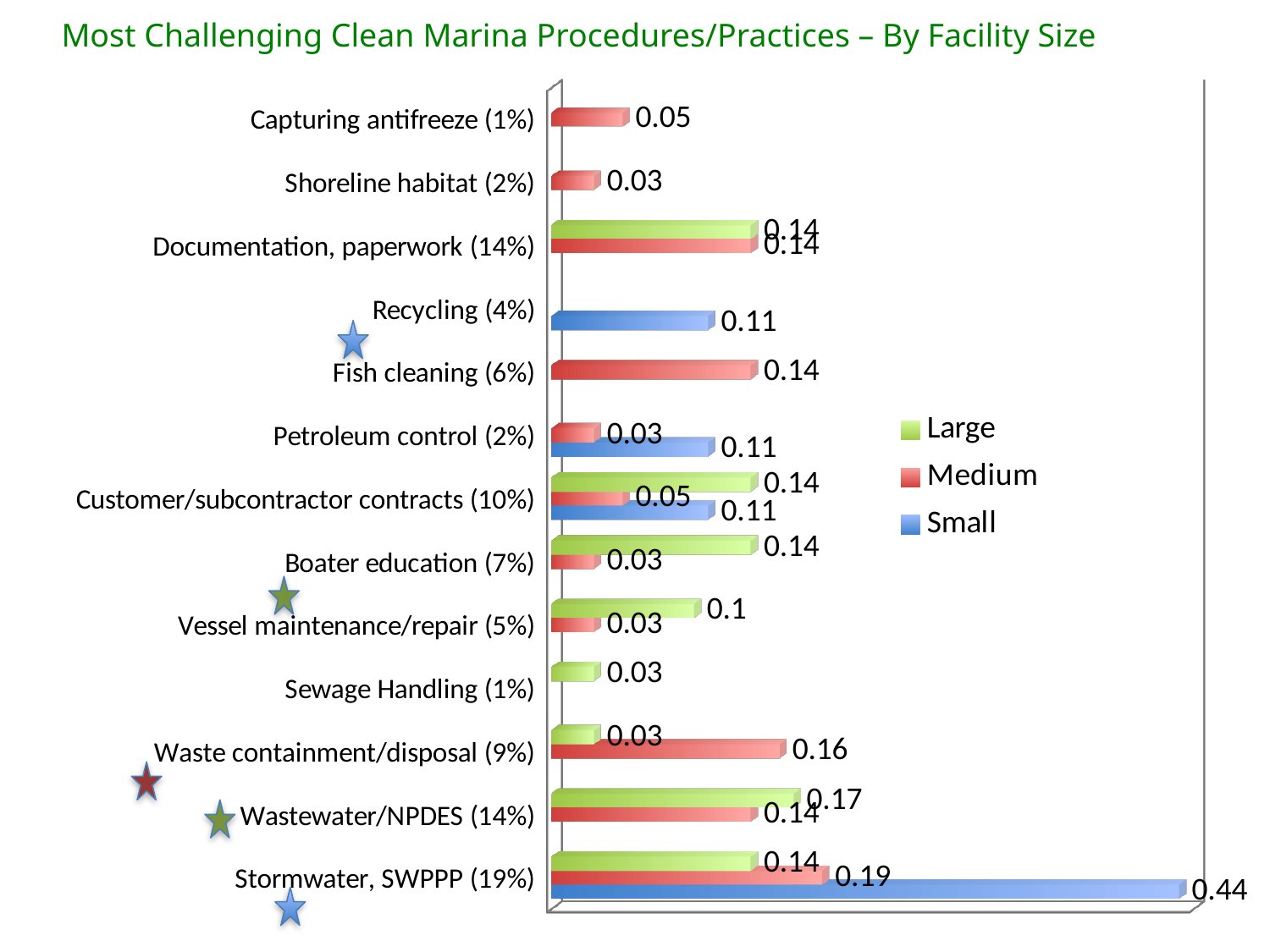
What is the Large value for Vessel maintenance/repair (5%)? 0.1 Which category has the highest Large value? Wastewater/NPDES (14%) What is the Medium value for Waste containment/disposal (9%)? 0.16 What is the Medium value for Capturing antifreeze (1%)? 0.05 How many series does the legend list? 3 How many categories are shown on the chart? 13 For Wastewater/NPDES (14%), which is larger, the Large value or the Medium value? Large What are the three series listed in the legend? Large, Medium, Small What kind of chart is shown on the slide? bar chart What is the Small value for Stormwater, SWPPP (19%)? 0.44 What is the difference between the Small and Medium values for Stormwater, SWPPP (19%)? 0.25 Which category has the highest value on the chart? Stormwater, SWPPP (19%)